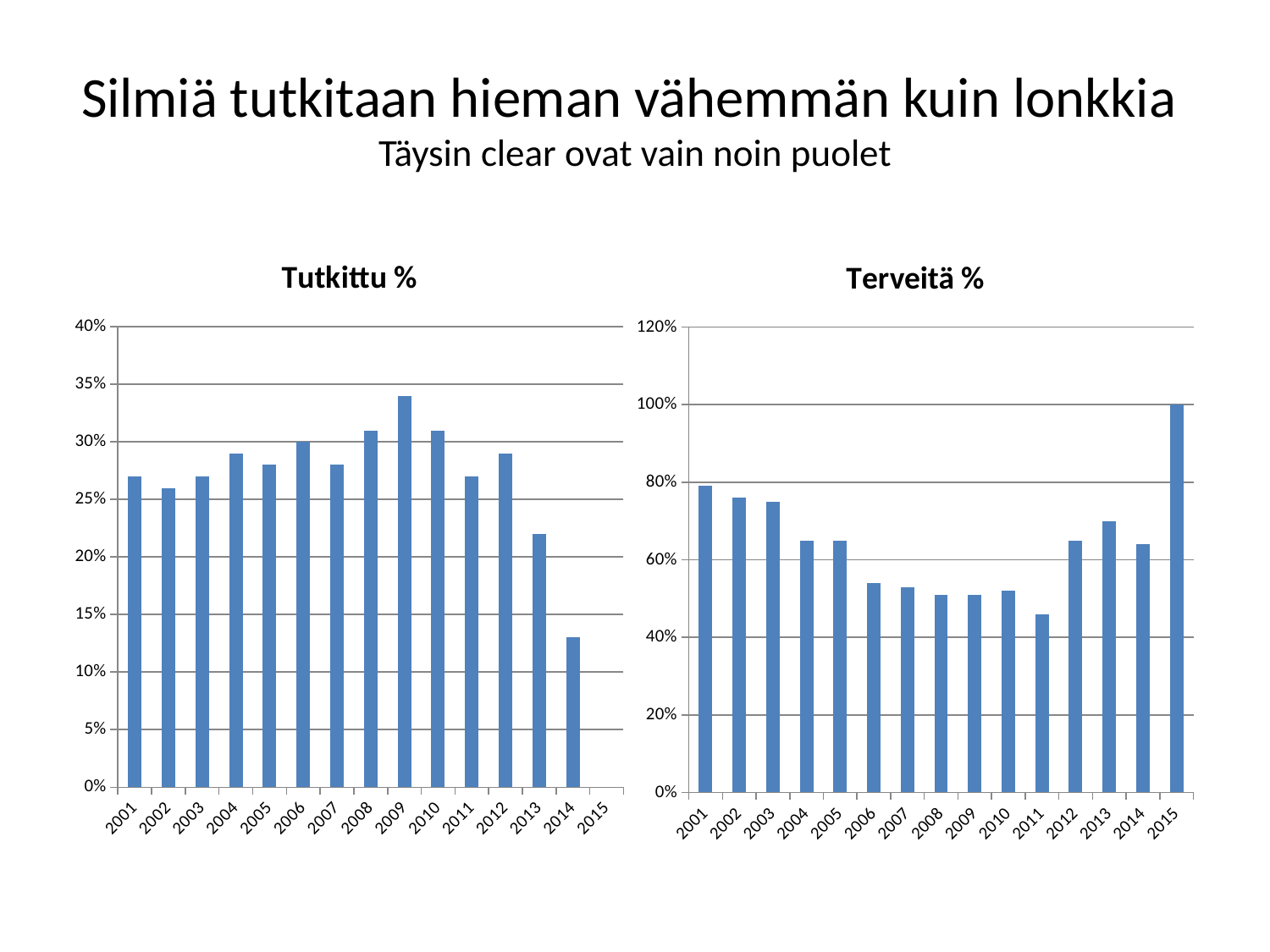
In the "Terveitä %" chart, how many years are plotted? 15 In the "Terveitä %" chart, do the values rise or fall from 2001 to 2011? fall In the "Tutkittu %" chart, what is the value for 2006? 30% In the "Tutkittu %" chart, which year has the highest value? 2009 In the "Tutkittu %" chart, is the value for 2014 greater or less than 15%? less In the "Tutkittu %" chart, is the value for 2013 greater or less than 20%? greater What kind of chart is the "Tutkittu %" chart? bar chart In the "Terveitä %" chart, what is the value for 2015? 100% In the "Terveitä %" chart, which year has the lowest value? 2011 In the "Terveitä %" chart, which is larger, the value for 2001 or the value for 2011? 2001